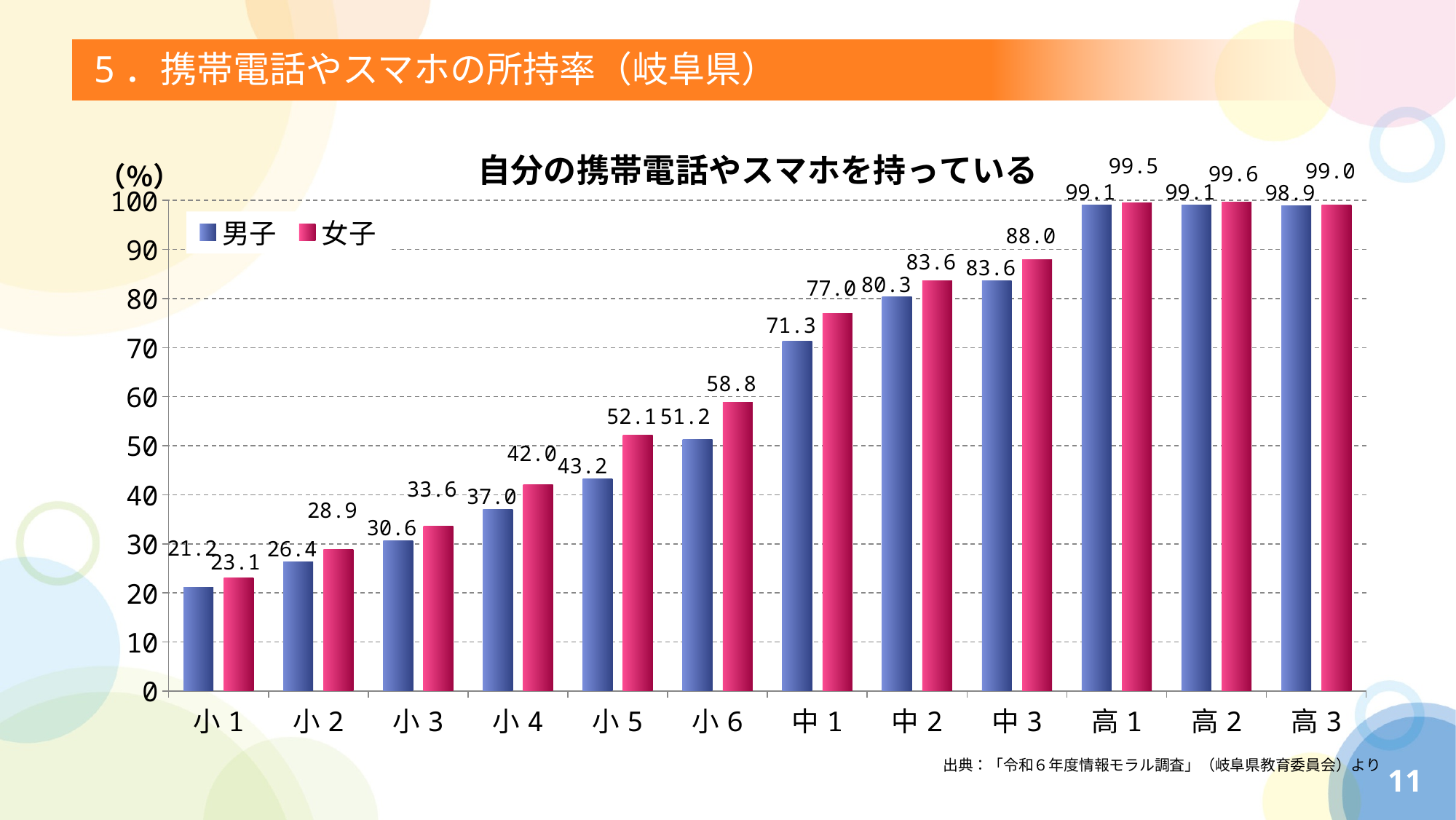
Do the values generally rise or fall from 小1 to 高3? Rise What is the difference between the 女子 and 男子 values at 中3? 4.4 At 小4, which is larger, the 男子 value or the 女子 value? 女子 How many grade categories are shown on the x axis? 12 What is the value for 女子 at 中3? 88.0 How many series does the legend list? 2 What is the title of the chart? 自分の携帯電話やスマホを持っている What is the value for 男子 at 中1? 71.3 Is the value for 女子 at 小6 greater or less than 50? greater What type of chart is shown on the slide? Bar chart What is the value for 女子 at 小5? 52.1 Which grade has the lowest value for 男子? 小1